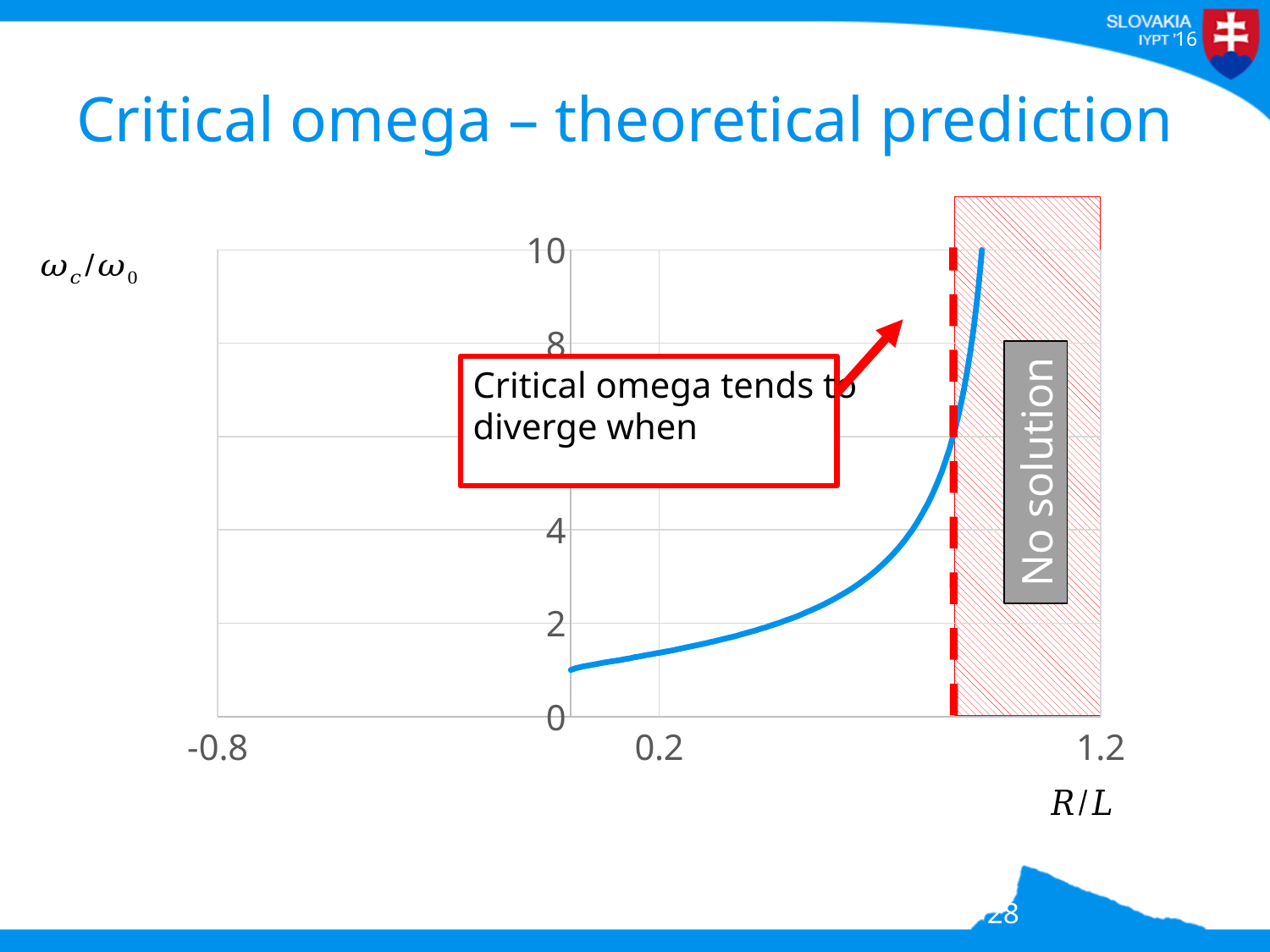
Is the value of the curve at R/L = 0.2 greater or less than 0? greater Is the value of the curve at R/L = 0.2 larger or smaller than its value just before the red dashed line? smaller Is the highest value reached by the curve greater or less than 8? greater What is the highest tick value shown on the y axis? 10 What kind of chart is shown on the slide? line chart How many curves are plotted on the chart? 1 What is the label on the x axis of the chart? R/L What is the title of the slide containing the chart? Critical omega – theoretical prediction What text labels the hatched region on the right side of the chart? No solution What is the lowest tick value shown on the x axis? -0.8 Is the value of the curve at R/L = 0.2 greater or less than 2? less Does the plotted curve rise or fall as R/L increases? rise